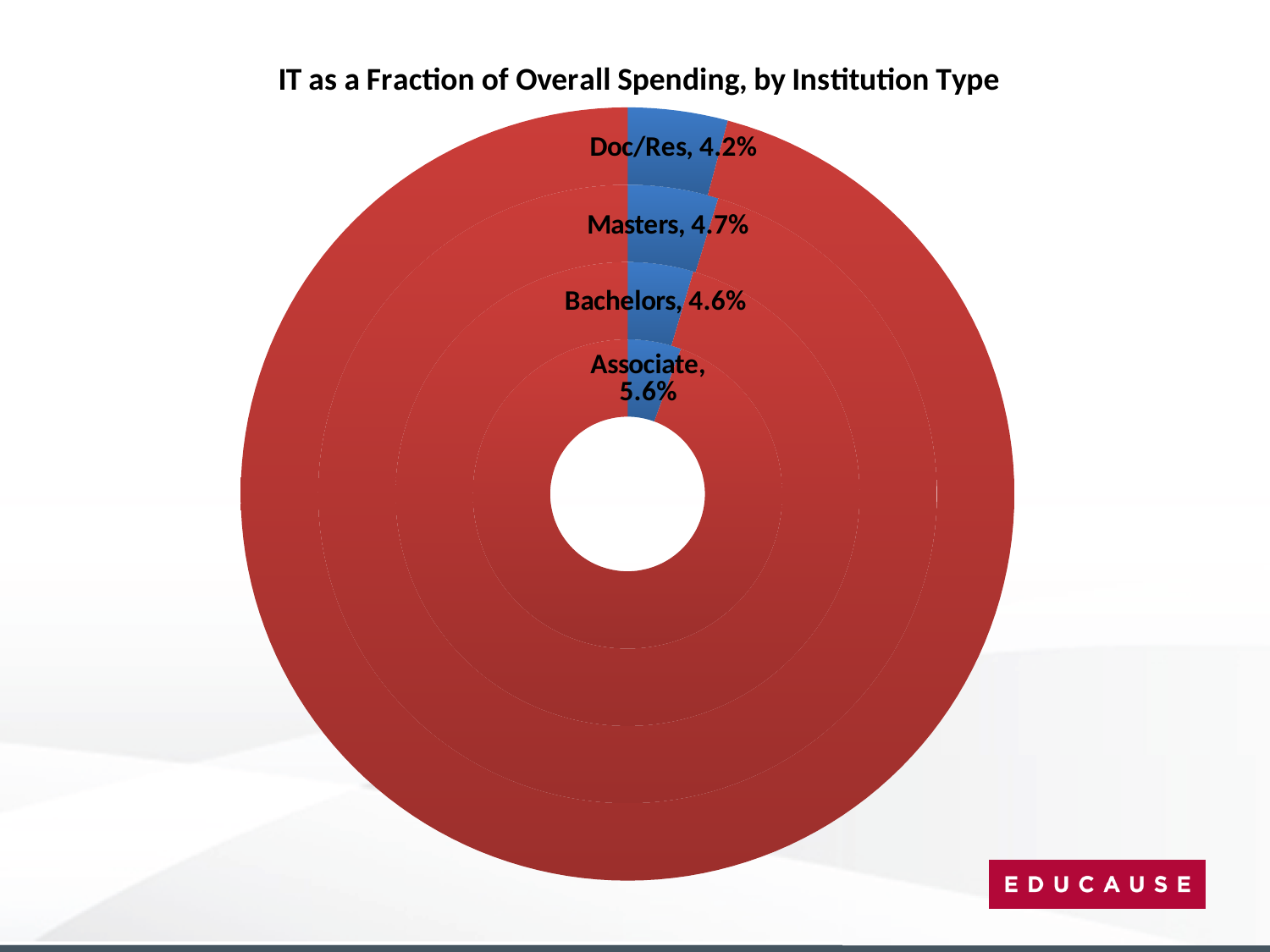
Which institution type has the lowest IT fraction of overall spending? Doc/Res What is the IT fraction of overall spending for Doc/Res institutions? 4.2% What is the title of the chart? IT as a Fraction of Overall Spending, by Institution Type Which institution type has the highest IT fraction of overall spending? Associate What is the IT fraction of overall spending for Bachelors institutions? 4.6% What is the difference in percentage points between the IT fraction for Associate and Doc/Res institutions? 1.4 percentage points What is the IT fraction of overall spending for Associate institutions? 5.6% What is the IT fraction of overall spending for Masters institutions? 4.7% How many institution types are shown in the chart? 4 What colour represents the IT portion of spending in each ring? Blue What kind of chart is shown on the slide? Doughnut (pie) chart Which has a larger IT fraction of overall spending, Masters or Bachelors institutions? Masters